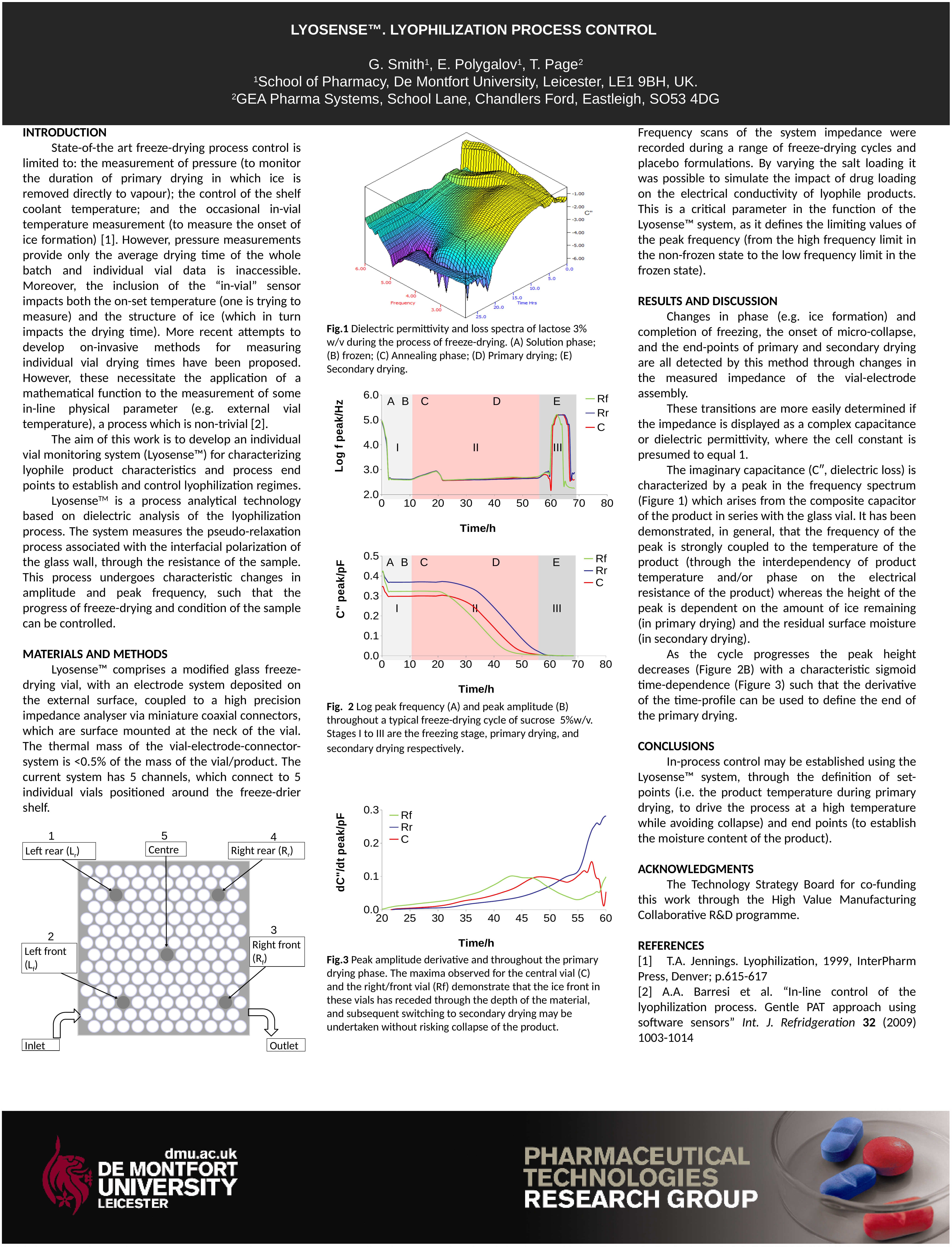
In the Fig. 2 top chart (Log f peak/Hz vs Time/h), is the value of Rf at 30 h greater or less than 3.0? less In the Fig. 2 bottom chart (C" peak/pF vs Time/h), is the value of Rr at 10 h greater or less than 0.3? greater In the Fig. 3 chart (dC"/dt peak/pF vs Time/h), what is the label of the x axis? Time/h In the Fig. 2 bottom chart (C" peak/pF vs Time/h), is the value of C at 10 h greater or less than 0.4? less In the Fig. 2 top chart (Log f peak/Hz vs Time/h), how many series does the legend list? 3 What kind of chart is the Fig. 2 top chart (Log f peak/Hz vs Time/h)? line chart In the Fig. 3 chart (dC"/dt peak/pF vs Time/h), which series has the larger value at 60 h, Rr or Rf? Rr In the Fig. 2 top chart (Log f peak/Hz vs Time/h), what colour is the line for series C in the legend? red In the Fig. 2 bottom chart (C" peak/pF vs Time/h), does the C series rise or fall between 20 h and 50 h? fall